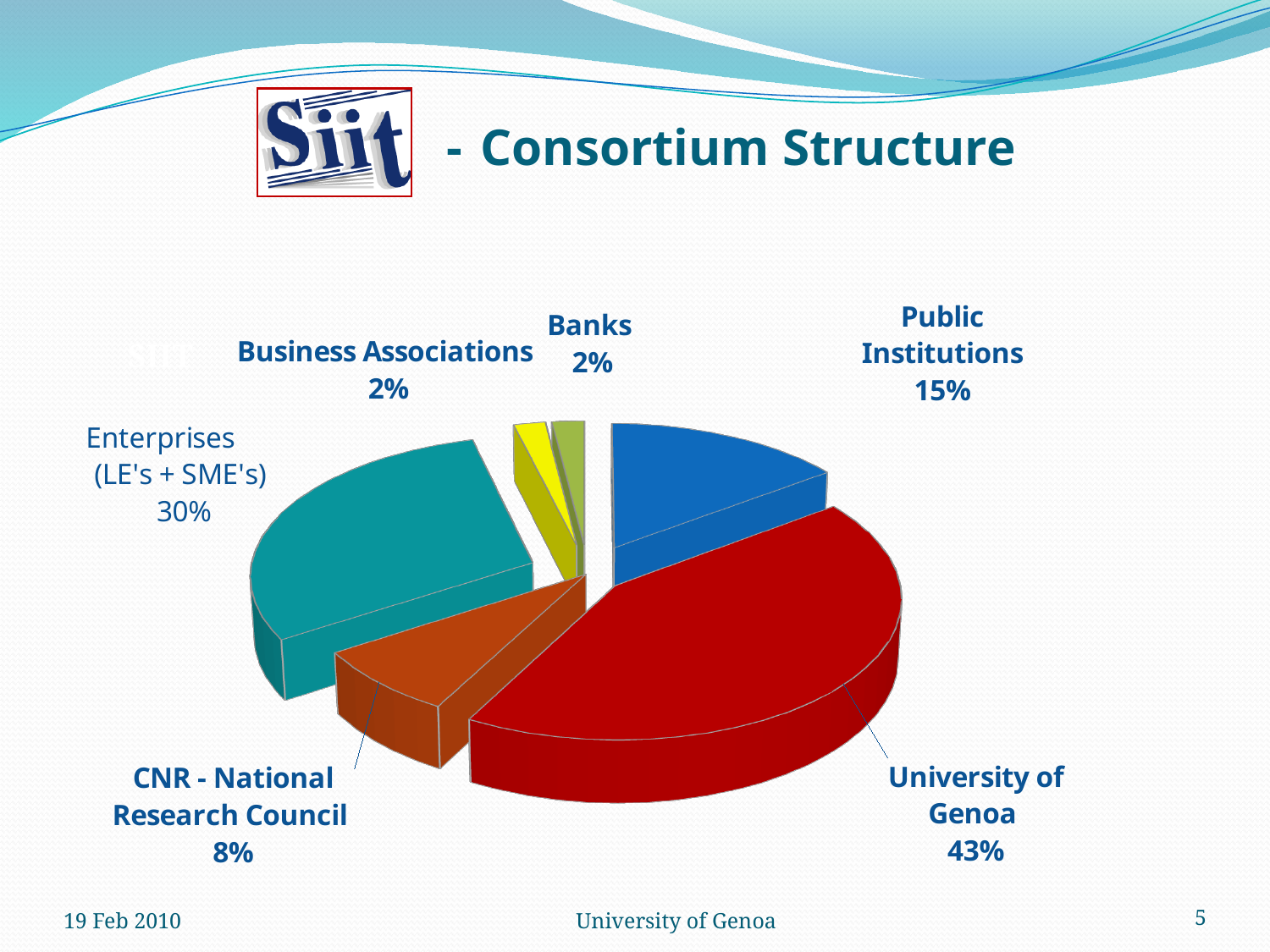
What is the combined share of Business Associations and Banks? 4% What colour is the University of Genoa slice? Red What kind of chart is shown on the slide? Pie chart Which is larger, Public Institutions or CNR - National Research Council? Public Institutions What percentage is shown for Public Institutions? 15% What percentage is shown for CNR - National Research Council? 8% What share of the consortium is the University of Genoa? 43% What percentage is shown for Enterprises (LE's + SME's)? 30% How many slices does the pie chart have? 6 Which slice of the pie is the largest? University of Genoa What is the difference in percentage points between University of Genoa and Enterprises (LE's + SME's)? 13 What percentage is shown for Banks? 2%